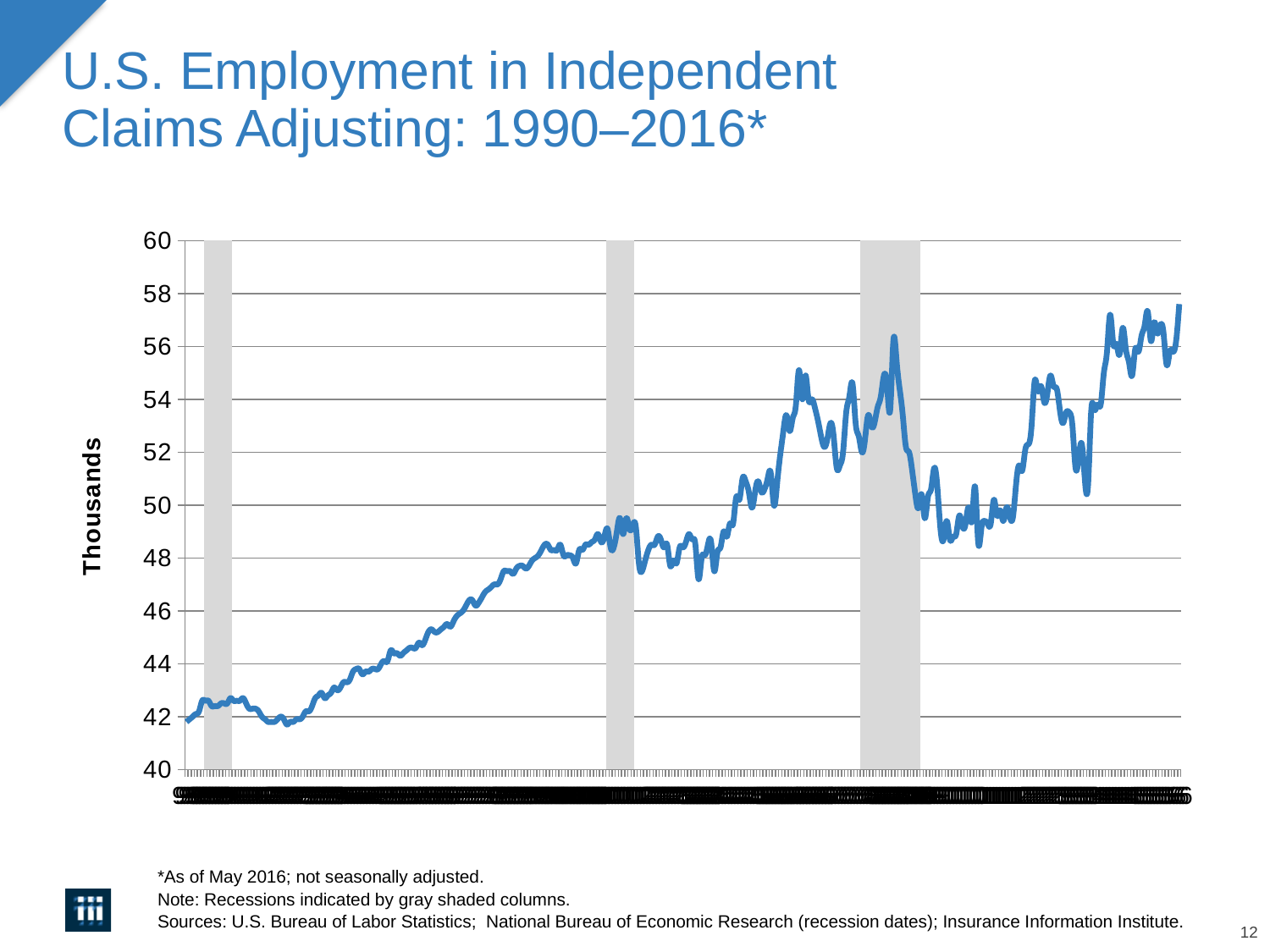
What is the label on the vertical axis? Thousands What is the title of the chart? U.S. Employment in Independent Claims Adjusting: 1990–2016* How many gray shaded recession columns are shown on the chart? 3 Is the value at the end of the series (far right) greater or less than 56? greater Is the lowest point of the line greater or less than 44? less What kind of chart is shown on the slide? line chart Is the value at the end of the series greater or less than the value at the start of the series? greater Overall, do the values rise or fall from the left of the x axis to the right? rise Is the value at the start of the series (far left) greater or less than 44? less